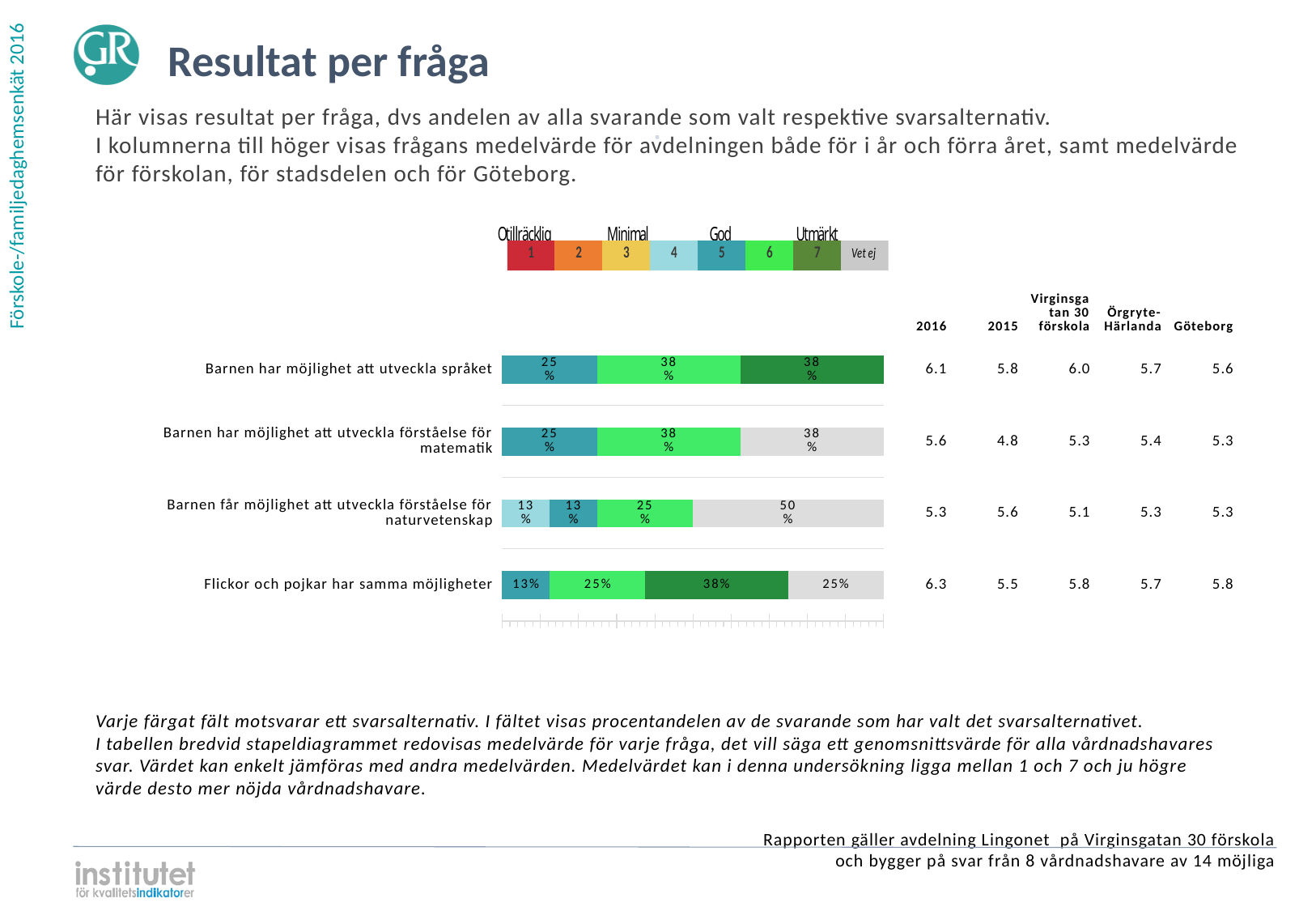
Is the '7' (dark green) share larger for 'Barnen har möjlighet att utveckla språket' or for 'Flickor och pojkar har samma möjligheter'? They are equal (38%) How many questions (categories) are plotted in the bar chart? 4 How many response options does the colour legend above the chart list? 8 What percentage of respondents chose 'Vet ej' for 'Barnen har möjlighet att utveckla förståelse för matematik'? 38% Which question has the largest 'Vet ej' (grey) share? Barnen får möjlighet att utveckla förståelse för naturvetenskap Which question has no 'Vet ej' (grey) segment at all? Barnen har möjlighet att utveckla språket What percentage of respondents chose the dark green '7' (Utmärkt) option for 'Flickor och pojkar har samma möjligheter'? 38% What kind of chart is shown on the slide? Stacked bar chart What is the difference between the 'Vet ej' share for 'Barnen får möjlighet att utveckla förståelse för naturvetenskap' (50%) and for 'Flickor och pojkar har samma möjligheter' (25%)? 25% What percentage of respondents chose the teal '5' option for 'Barnen har möjlighet att utveckla språket'? 25% What percentage of respondents chose 'Vet ej' for 'Barnen får möjlighet att utveckla förståelse för naturvetenskap'? 50% What is the label of the grey legend entry at the right end of the colour scale? Vet ej